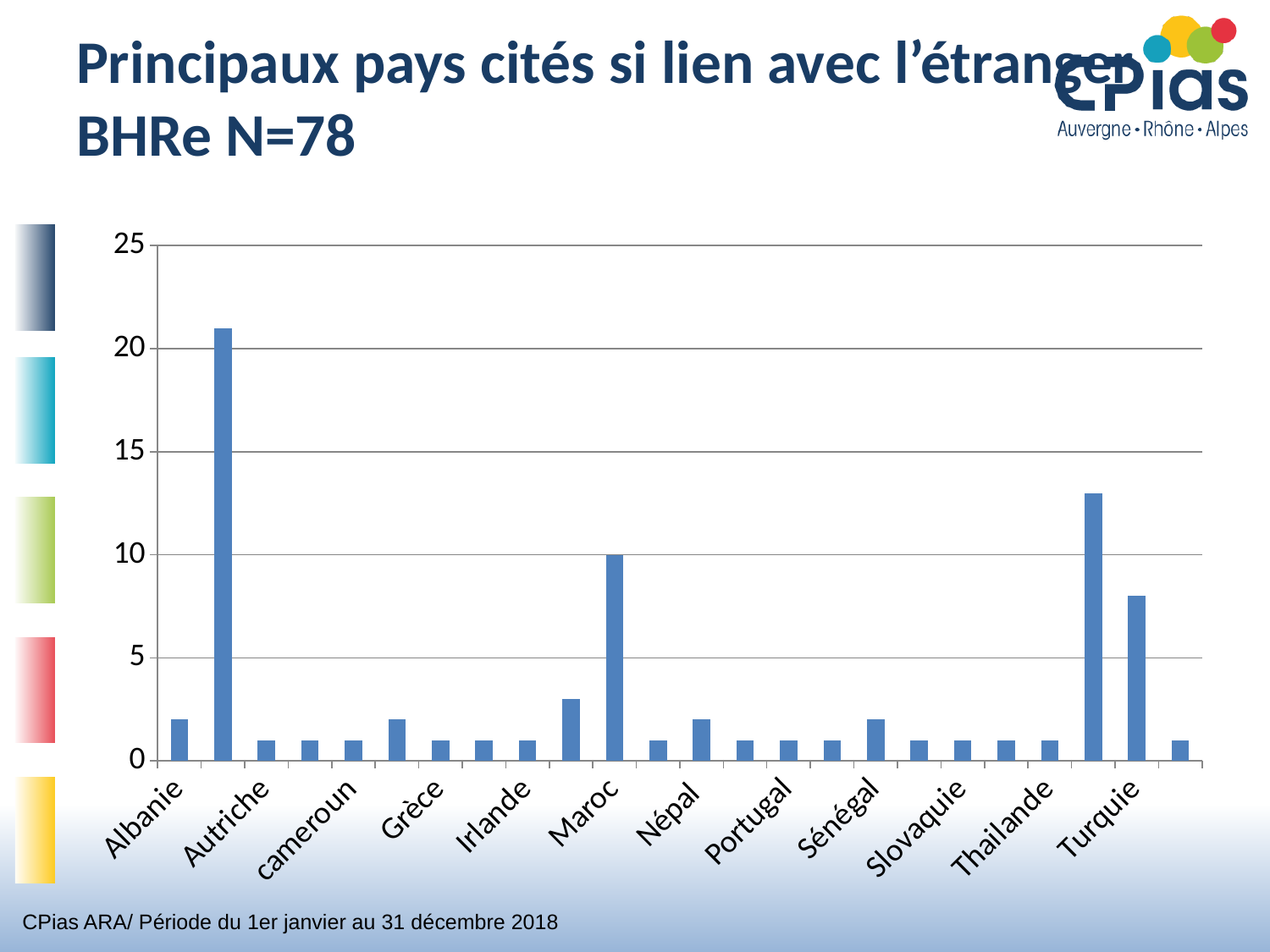
Is the value for Turquie greater or less than 10? less Which has the larger value, Maroc or Albanie? Maroc Which has the larger value, Maroc or Turquie? Maroc What kind of chart is shown on the slide? bar chart How many country labels are shown on the x axis? 12 How many bars on the chart exceed 15? 1 Is the value for Maroc greater or less than 5? greater Is the value for Maroc greater or less than 15? less What is the highest value shown on the y axis? 25 What is the title of the chart on the slide? Principaux pays cités si lien avec l'étranger BHRe N=78